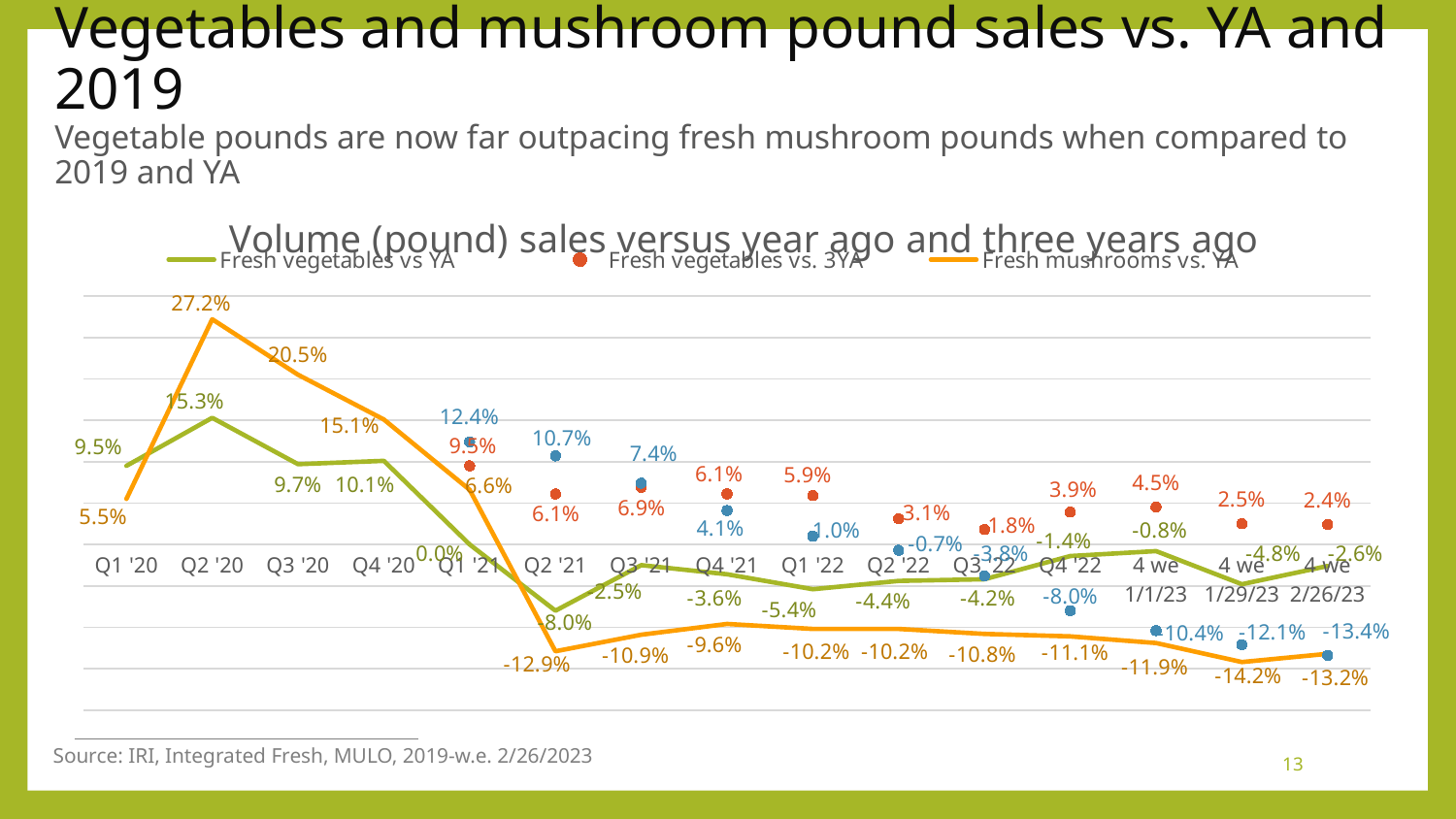
In which period does Fresh mushrooms vs. YA reach its highest value? Q2 '20 How many series does the chart legend list? 3 In Q2 '20, how many percentage points higher is Fresh mushrooms vs. YA than Fresh vegetables vs YA? 11.9 percentage points What kind of chart is shown on the slide? Line chart What is the title of the chart? Volume (pound) sales versus year ago and three years ago In which period does Fresh mushrooms vs. YA reach its lowest value? 4 we 1/29/23 What is the value for Fresh mushrooms vs. YA in Q2 '20? 27.2% What is the value for Fresh vegetables vs YA in Q2 '20? 15.3% What is the value for Fresh vegetables vs. 3YA for the 4 weeks ending 1/1/23? 4.5% What is the value for Fresh mushrooms vs. YA in Q2 '21? -12.9% In Q1 '20, which is larger: Fresh vegetables vs YA or Fresh mushrooms vs. YA? Fresh vegetables vs YA How many time periods are shown along the x axis of the chart? 15